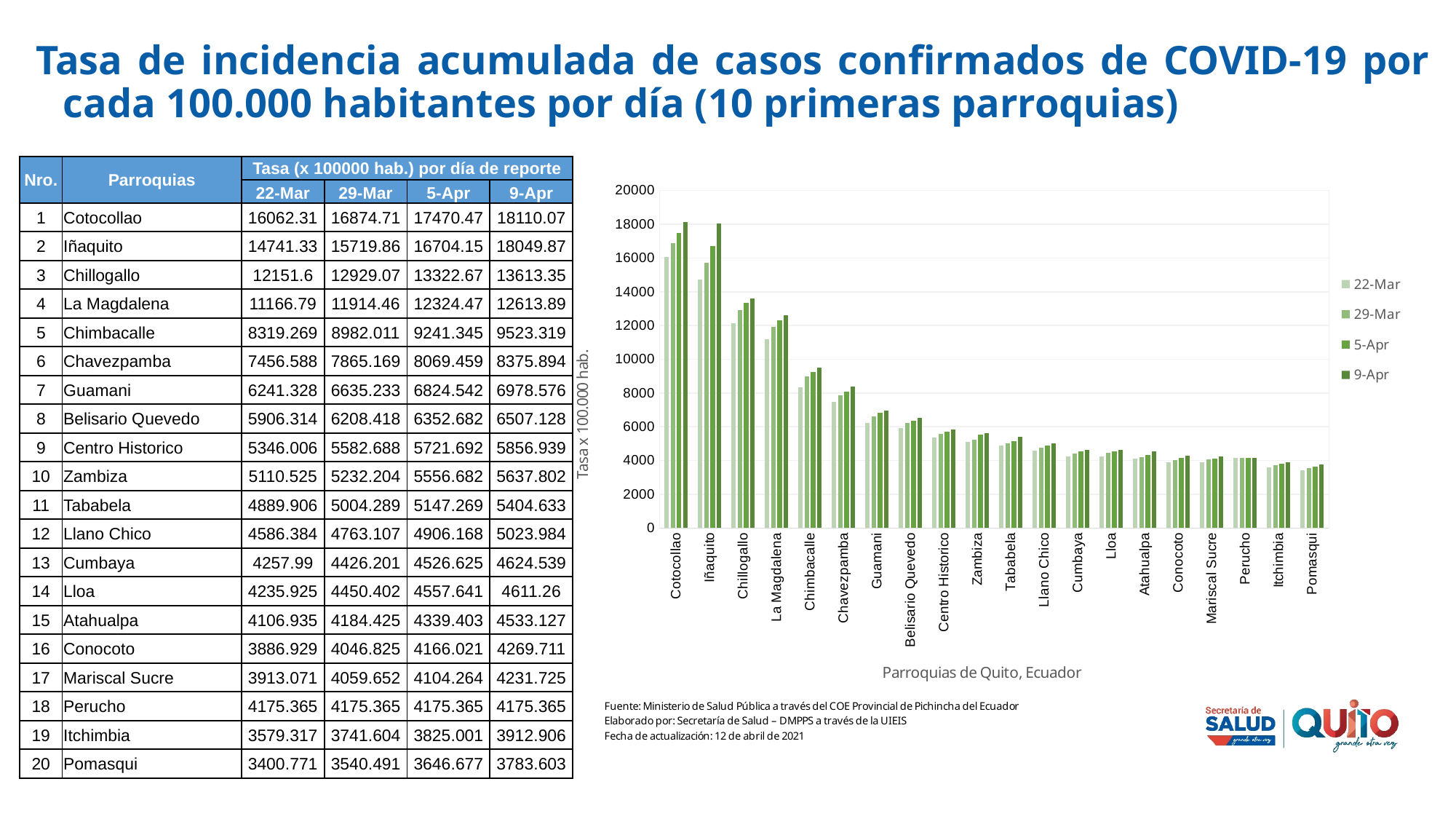
What kind of chart is shown on the slide? Bar chart What is the difference between the 9-Apr and 22-Mar values for Cotocollao? 2047.76 What is the 9-Apr value for Cotocollao? 18110.07 Do the bar heights generally rise or fall moving from left to right along the x axis? Fall Which parroquia has the lowest 9-Apr value in the chart? Pomasqui Which parroquia has the highest 22-Mar value in the chart? Cotocollao What is the title of the chart's x axis? Parroquias de Quito, Ecuador Is the 9-Apr value for Perucho greater or less than 6000? less Which has the larger 9-Apr value, Guamani or Belisario Quevedo? Guamani Is the 9-Apr value for Chillogallo greater or less than 12000? greater How many parroquias (categories) are plotted on the x axis of the chart? 20 How many series does the chart legend list? 4